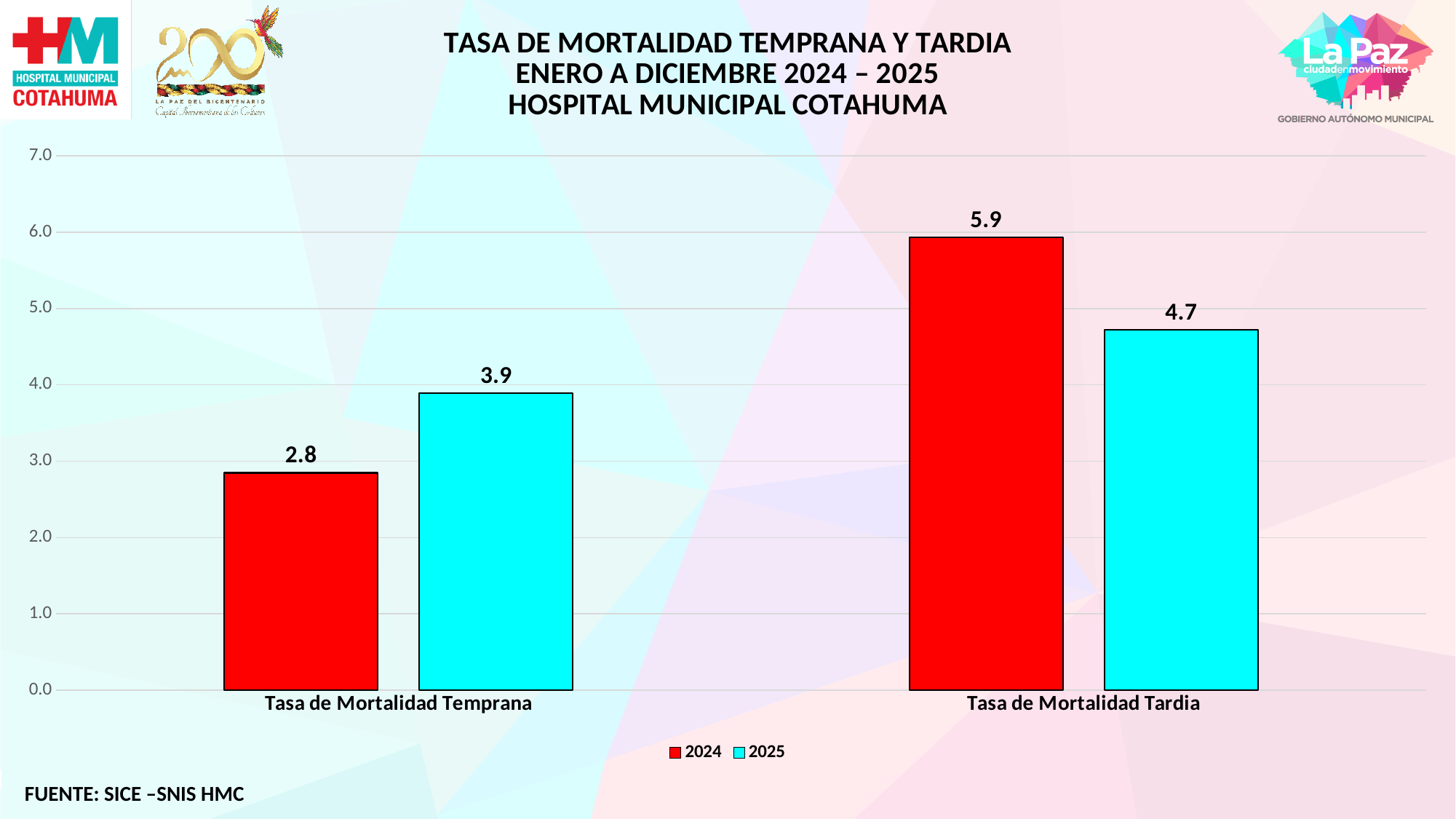
What is the value for 2025 in the Tasa de Mortalidad Temprana category? 3.9 How many series does the legend list? 2 How many categories are shown on the x axis? 2 Which bar has the highest value on the chart? 2024, Tasa de Mortalidad Tardia What is the value for 2024 in the Tasa de Mortalidad Temprana category? 2.8 What is the value for 2024 in the Tasa de Mortalidad Tardia category? 5.9 What is the difference between the 2025 and 2024 values for Tasa de Mortalidad Temprana? 1.1 Which bar has the lowest value on the chart? 2024, Tasa de Mortalidad Temprana What kind of chart is shown on the slide? Bar chart What is the difference between the 2024 and 2025 values for Tasa de Mortalidad Tardia? 1.2 What is the value for 2025 in the Tasa de Mortalidad Tardia category? 4.7 For Tasa de Mortalidad Temprana, which year has the larger value, 2024 or 2025? 2025